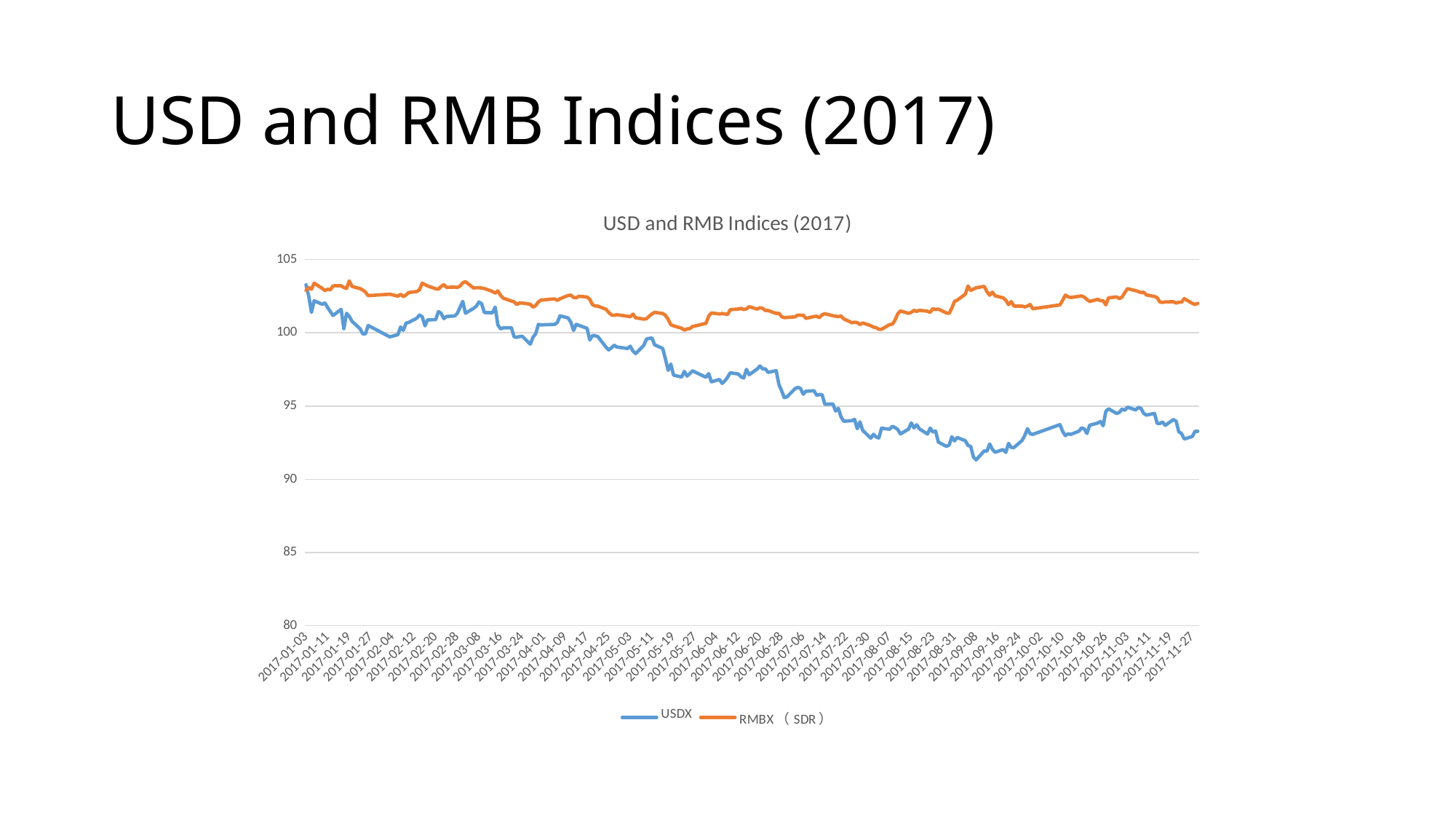
Which series is drawn in orange? RMBX (SDR) What is the title of the chart? USD and RMB Indices (2017) Is the USDX value around 2017-07-30 greater or less than 95? less Is the USDX value at 2017-01-03 greater or less than 100? greater What kind of chart is shown on the slide? line chart How many series does the legend list? 2 Is the RMBX (SDR) value at 2017-11-27 greater or less than 100? greater Does the USDX series generally rise or fall from January to November 2017? fall Which series has the higher value at 2017-11-27, USDX or RMBX (SDR)? RMBX (SDR) Which series has the higher value around 2017-06-12, USDX or RMBX (SDR)? RMBX (SDR)